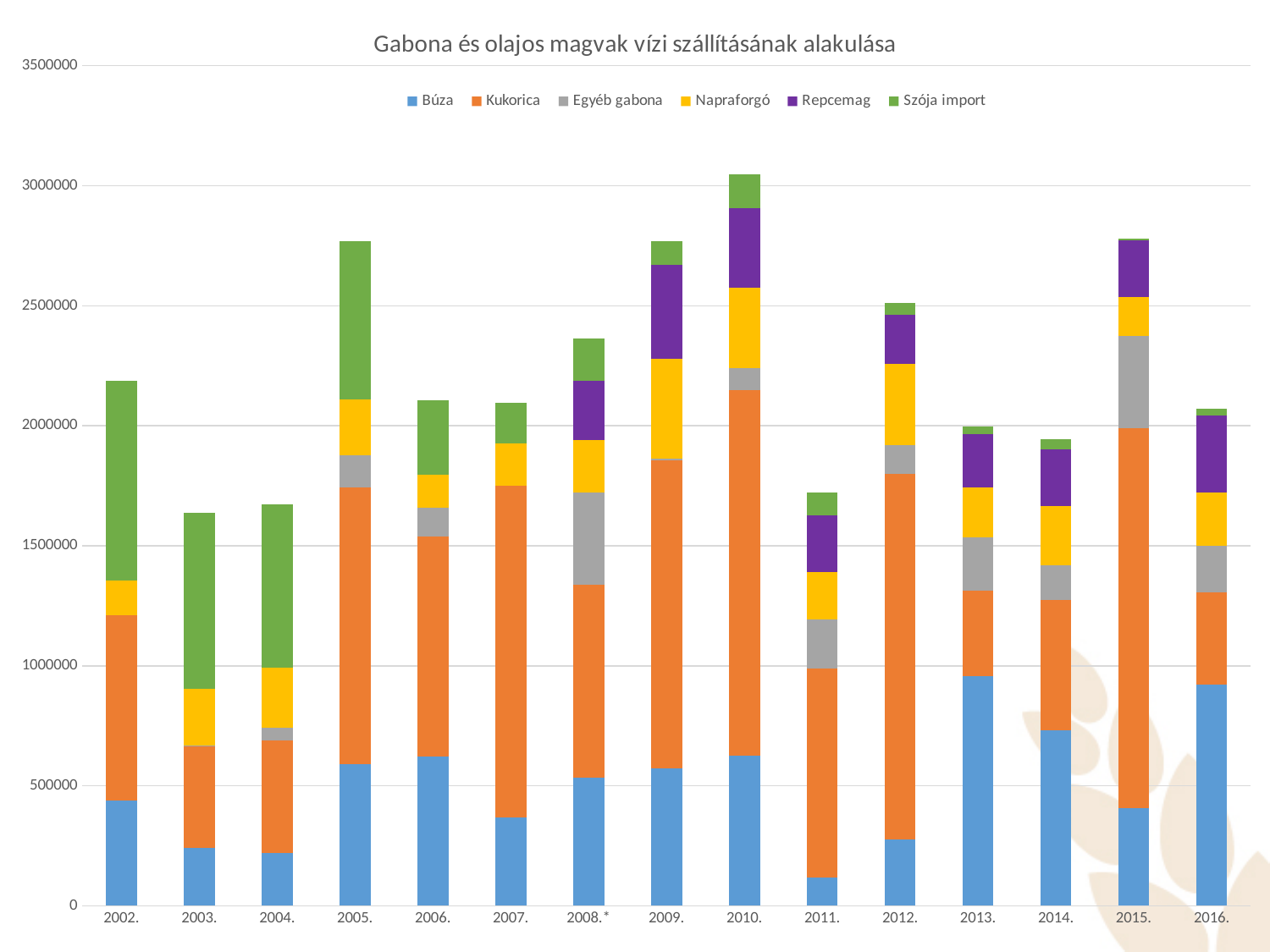
How many series does the legend list? 6 Is the Búza value for 2013. greater or less than 500000? greater What kind of chart is shown on the slide? Stacked bar chart Is the Búza value for 2011. greater or less than 500000? less Is the total for 2002. greater or less than 2000000? greater Which year has the highest total stacked bar? 2010. Which year has the larger Búza value, 2013. or 2014.? 2013. How many years (bars) are shown on the x axis? 15 Which year has the larger total stacked bar, 2005. or 2006.? 2005. Does the Búza value rise or fall from 2011. to 2013.? rise